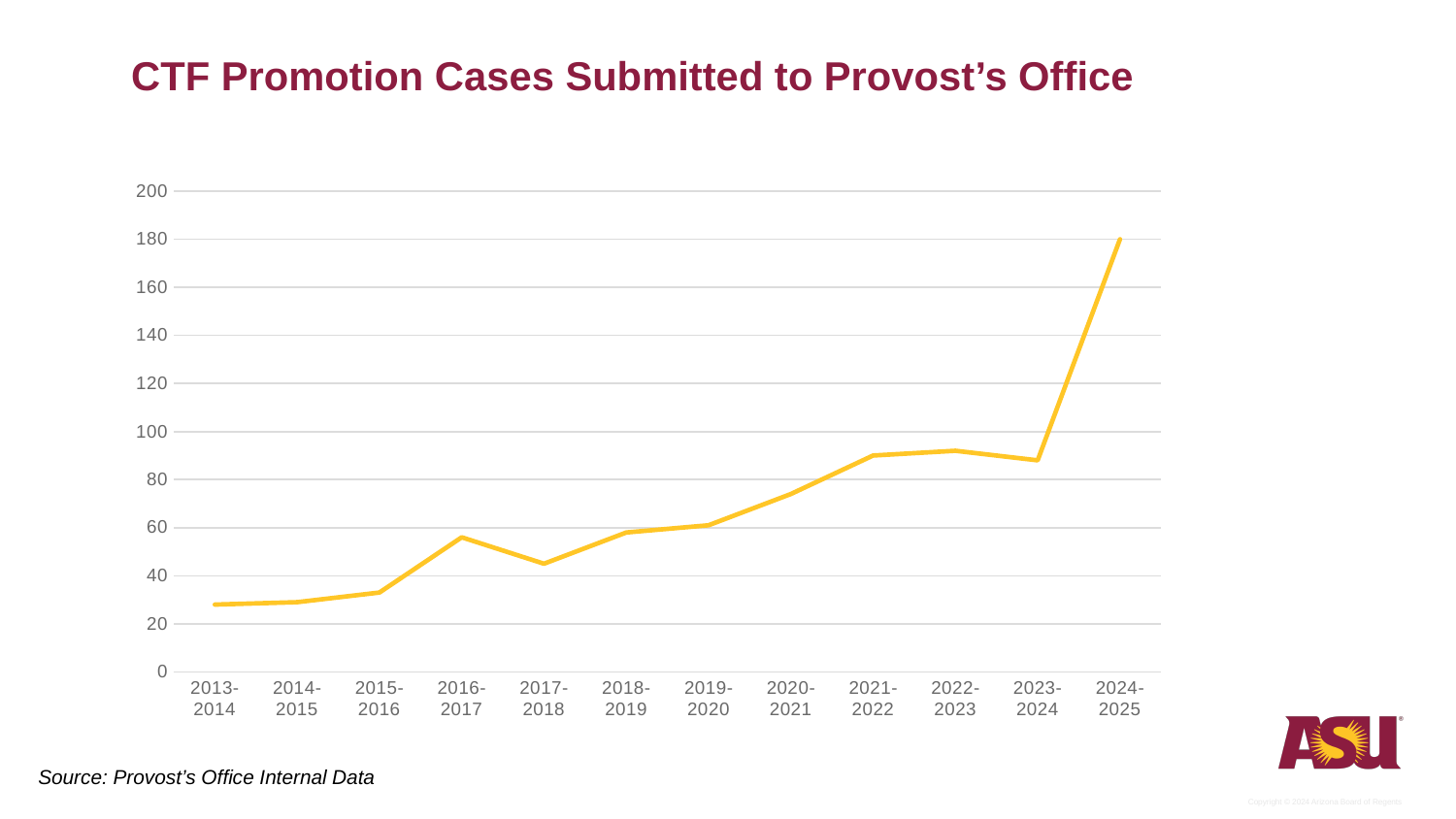
How many academic years are plotted on the x axis? 12 Which year has the larger value, 2016-2017 or 2017-2018? 2016-2017 What is the title of the chart? CTF Promotion Cases Submitted to Provost's Office Is the value for 2017-2018 greater or less than 60? less Is the value for 2021-2022 greater or less than 80? greater Which year has the larger value, 2023-2024 or 2024-2025? 2024-2025 Which academic year has the highest number of CTF promotion cases submitted? 2024-2025 Is the value for 2024-2025 greater or less than 160? greater Overall, do the values rise or fall from 2013-2014 to 2024-2025? rise What kind of chart is shown on the slide? line chart